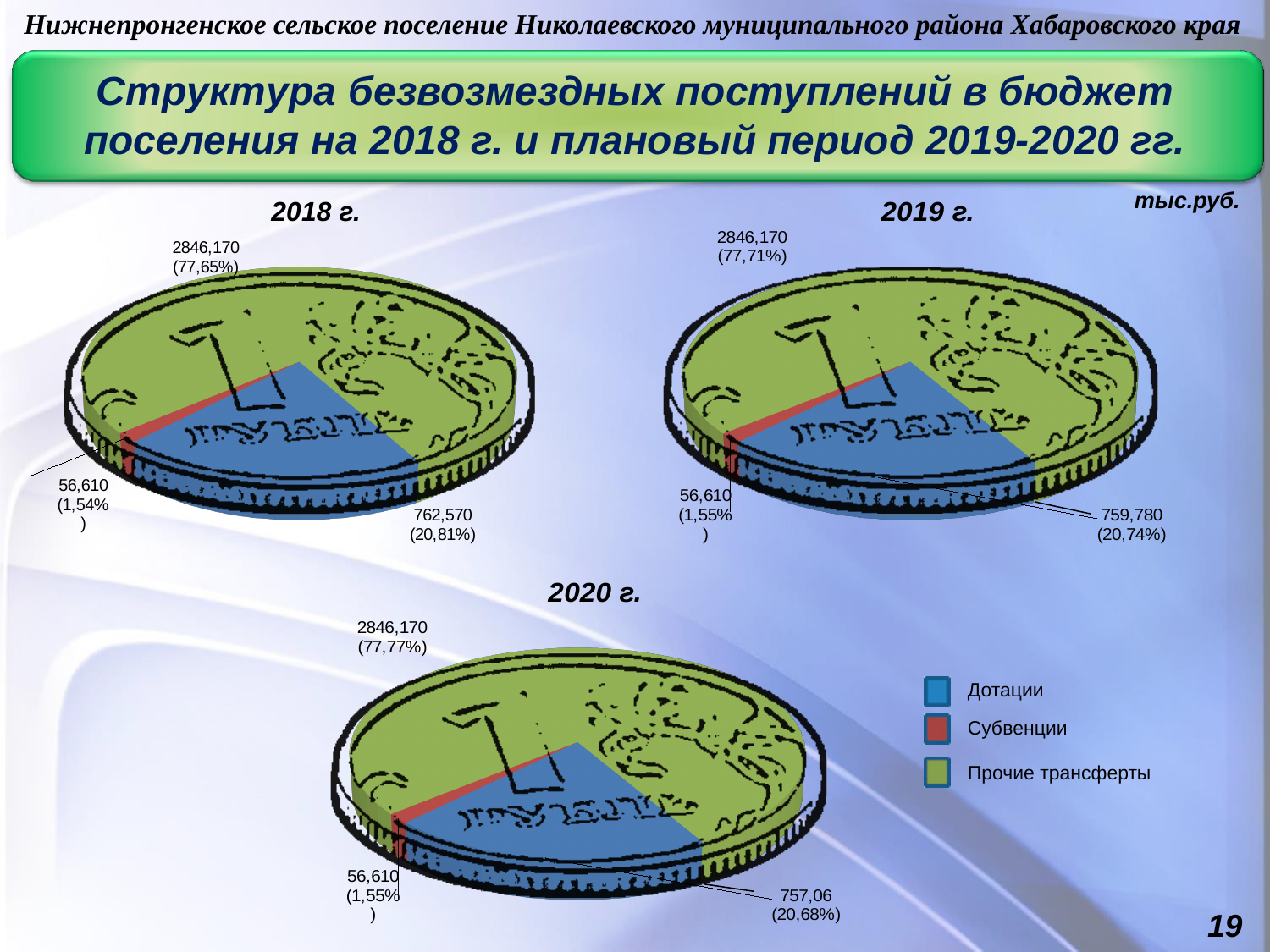
On the 2020 г. pie chart, what is the value for Дотации? 757,06 On the 2020 г. pie chart, what share of the pie is Прочие трансферты? 77,77% On the 2019 г. pie chart, which is larger: Дотации or Субвенции? Дотации On the 2018 г. pie chart, what share of the pie is Дотации? 20,81% How many categories does the legend list? 3 On the 2018 г. pie chart, which category has the smallest value? Субвенции On the 2019 г. pie chart, what is the value for Дотации? 759,780 On the 2019 г. pie chart, what share of the pie is Субвенции? 1,55% On the 2018 г. pie chart, what is the value for Прочие трансферты? 2846,170 What kind of chart is used for 2018 г.? Pie chart Which colour represents Субвенции in the legend? Red On the 2020 г. pie chart, which category has the largest value? Прочие трансферты